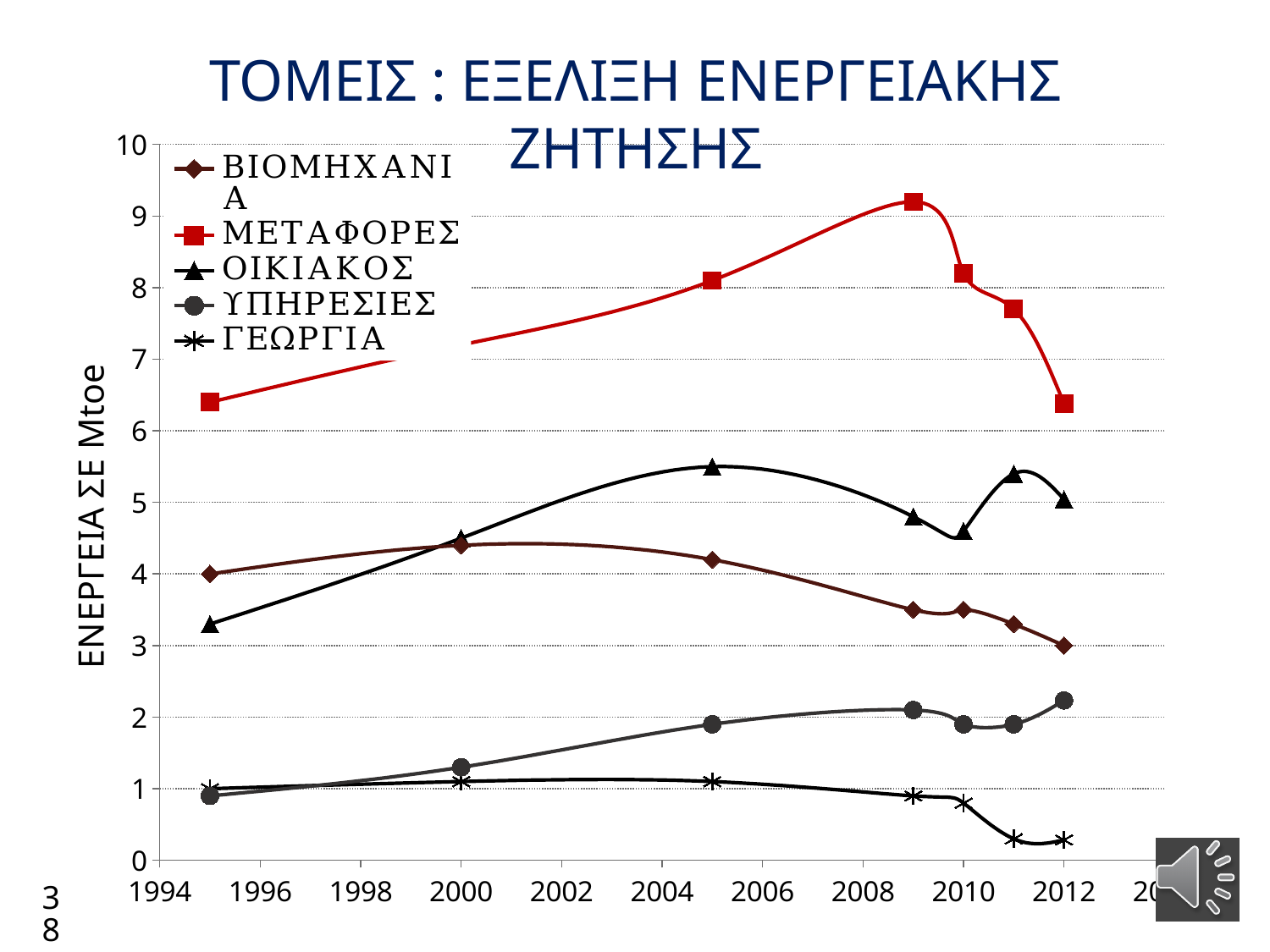
Is the value for ΟΙΚΙΑΚΟΣ in 2005 greater or less than 5? greater Which series has the highest values throughout the chart? ΜΕΤΑΦΟΡΕΣ Which series has the lowest value in 2012? ΓΕΩΡΓΙΑ What kind of chart is shown on the slide? Line chart Which is larger in 1995, the value for ΒΙΟΜΗΧΑΝΙΑ or the value for ΟΙΚΙΑΚΟΣ? ΒΙΟΜΗΧΑΝΙΑ Is the value for ΜΕΤΑΦΟΡΕΣ in 2009 greater or less than 8? greater Does the ΜΕΤΑΦΟΡΕΣ series rise or fall between 1995 and 2009? rise Does the ΓΕΩΡΓΙΑ series rise or fall between 2009 and 2012? fall How many series does the legend list? 5 What is the label of the vertical axis? ΕΝΕΡΓΕΙΑ ΣΕ Mtoe Is the value for ΓΕΩΡΓΙΑ in 2011 greater or less than 1? less